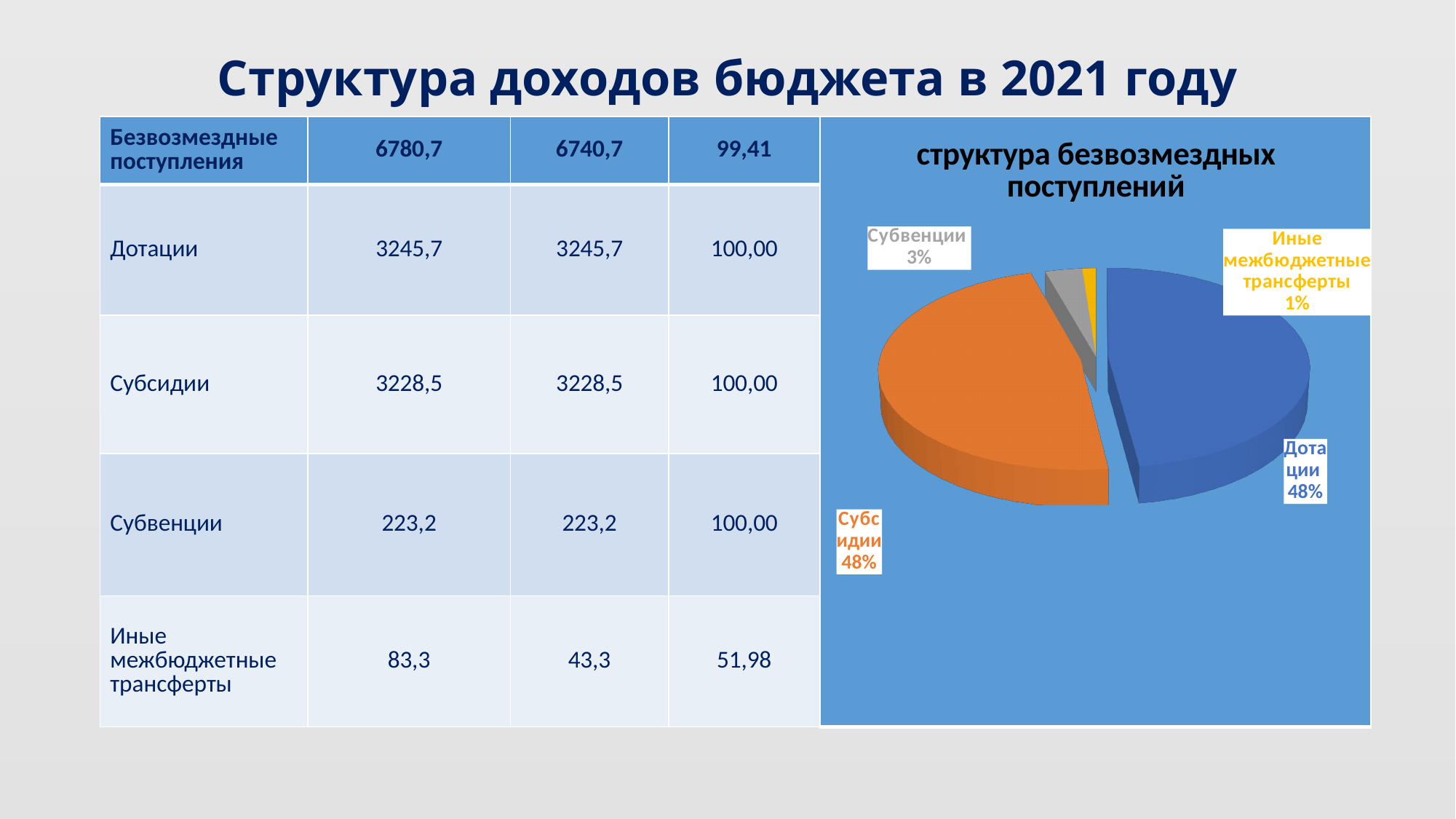
What share of the pie does Дотации have? 48% Which slice of the pie chart is the smallest? Иные межбюджетные трансферты What share of the pie does Иные межбюджетные трансферты have? 1% How many slices does the pie chart have? 4 By how many percentage points does the Субвенции share exceed the Иные межбюджетные трансферты share? 2 What is the title of the pie chart? структура безвозмездных поступлений What colour is the Субсидии slice in the pie chart? orange What share of the pie does Субсидии have? 48% What kind of chart is shown on the slide? pie chart Which slice is larger, Субвенции or Иные межбюджетные трансферты? Субвенции